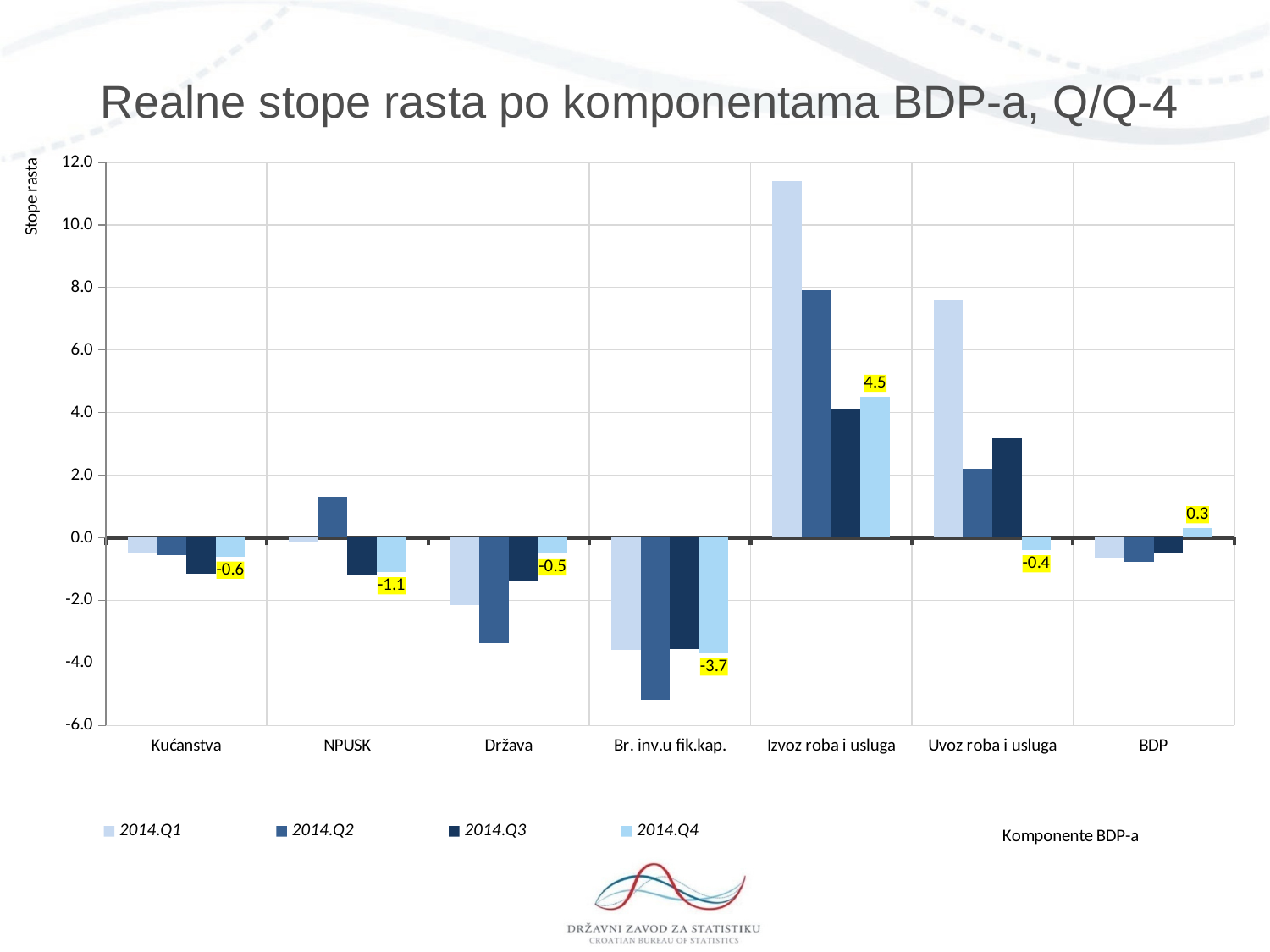
What is the value for Izvoz roba i usluga in the 2014.Q4 series? 4.5 What is the difference between the 2014.Q4 values for Izvoz roba i usluga and BDP? 4.2 What is the value for BDP in the 2014.Q4 series? 0.3 What is the value for NPUSK in the 2014.Q4 series? -1.1 How many categories are shown on the x axis? 7 Which category has the highest value in the 2014.Q4 series? Izvoz roba i usluga Which category has the lowest value in the 2014.Q4 series? Br. inv.u fik.kap. In the 2014.Q4 series, which is larger: the value for Uvoz roba i usluga or the value for Kućanstva? Uvoz roba i usluga Is the 2014.Q2 value for Br. inv.u fik.kap. greater or less than -4.0? less What is the value for Br. inv.u fik.kap. in the 2014.Q4 series? -3.7 Is the 2014.Q1 value for Izvoz roba i usluga greater or less than 10.0? greater How many series does the legend list? 4